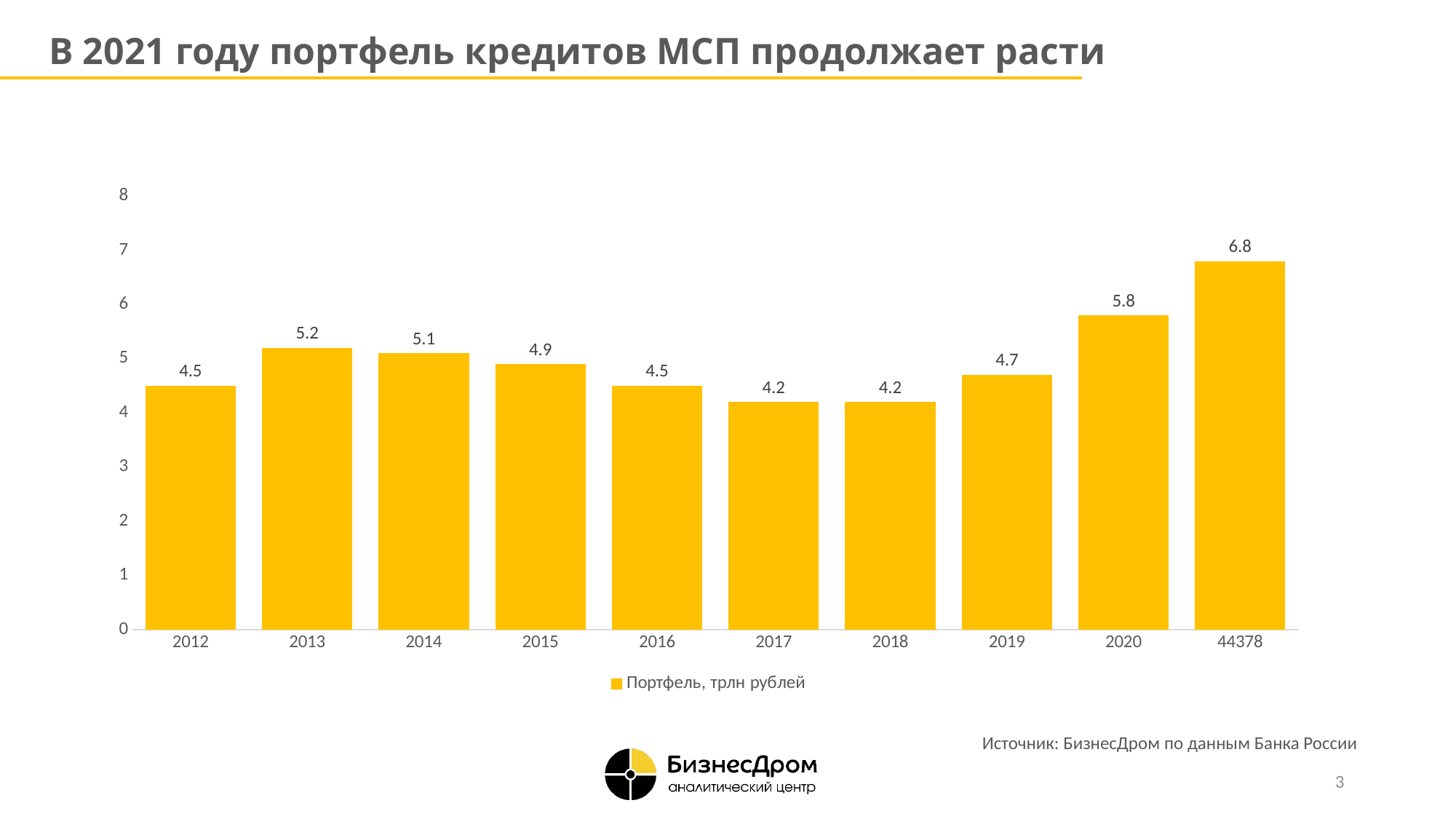
How many bars are shown in the chart? 10 What is the legend entry for the series shown? Портфель, трлн рублей What is the value for the last bar, labelled 44378? 6.8 Which category has the highest value? 44378 What is the value for 2020? 5.8 What is the difference between the values for 2020 and 2019? 1.1 Which is larger, the value for 2013 or the value for 2015? 2013 What is the value for 2017? 4.2 Which year has the highest value among 2012 to 2020? 2020 What is the value for 2013? 5.2 Is the value for 2014 greater or less than 4? greater What kind of chart is shown on the slide? Bar chart